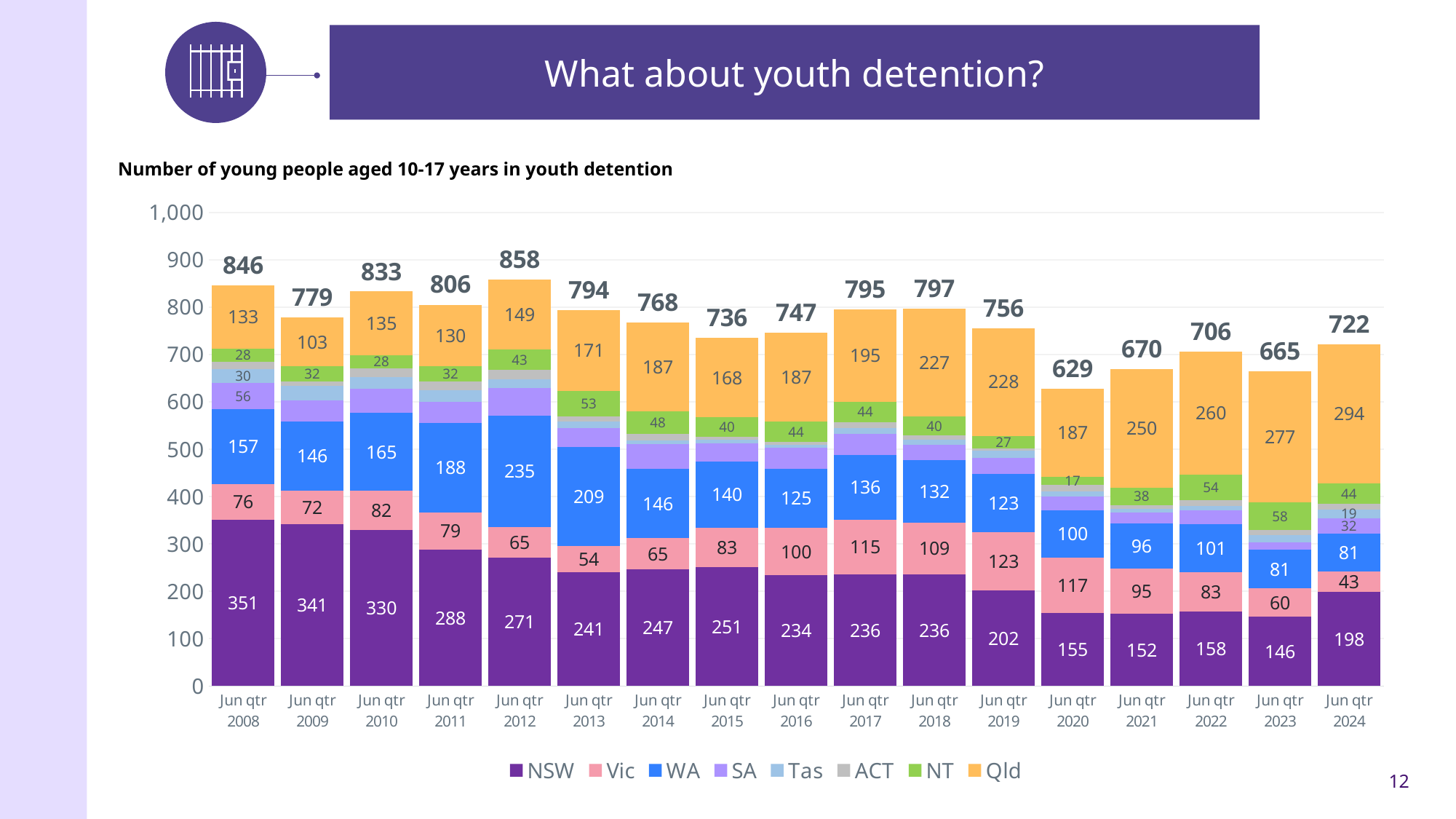
Which quarter has the lowest total number of young people in youth detention? Jun qtr 2020 What is the Qld value for Jun qtr 2024? 294 Which quarter has the highest total number of young people in youth detention? Jun qtr 2012 What is the NSW value for Jun qtr 2008? 351 How many quarters (categories) are shown along the x axis? 17 What type of chart is shown on the slide? Stacked bar chart What is the total number of young people in youth detention in Jun qtr 2024? 722 What is the difference between the total for Jun qtr 2012 and the total for Jun qtr 2020? 229 How many series does the legend list? 8 Does the Qld value rise or fall from Jun qtr 2020 to Jun qtr 2024? Rise In Jun qtr 2024, which is larger, the Qld value or the NSW value? Qld What is the WA value for Jun qtr 2012? 235